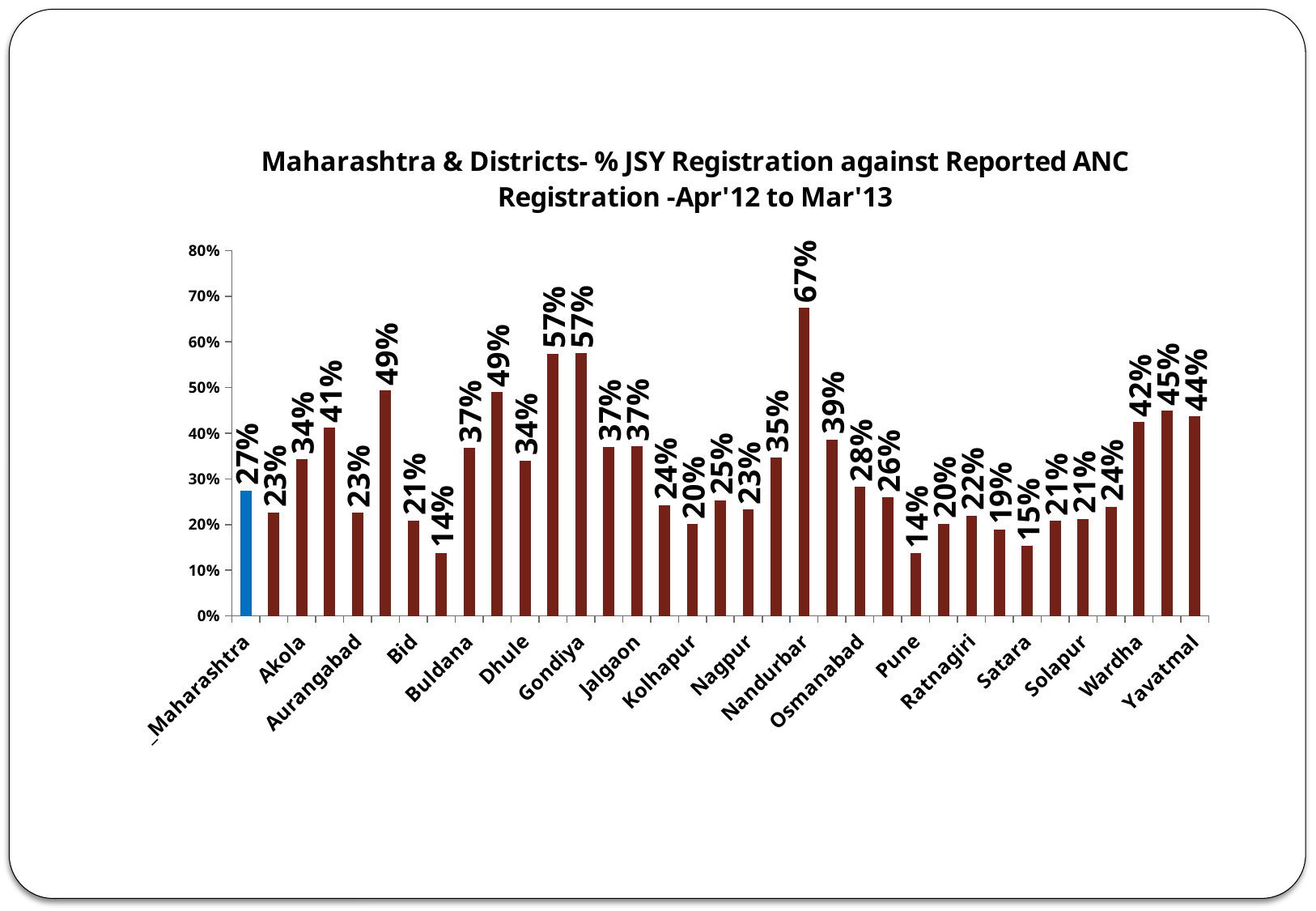
What period does the chart title say the data covers? Apr'12 to Mar'13 What is the value for Nandurbar? 67% What is the value for Gondiya? 57% Is the value for Yavatmal greater or less than 40%? greater Which bar is coloured blue rather than dark red? Maharashtra Which is larger, the value for Gondiya or the value for Jalgaon? Gondiya Which district has the highest value? Nandurbar What is the value for Pune? 14% What is the value for Maharashtra? 27% What is the value for Wardha? 42% What is the difference between the values for Nandurbar and Maharashtra? 40 percentage points What kind of chart is shown on the slide? Bar chart